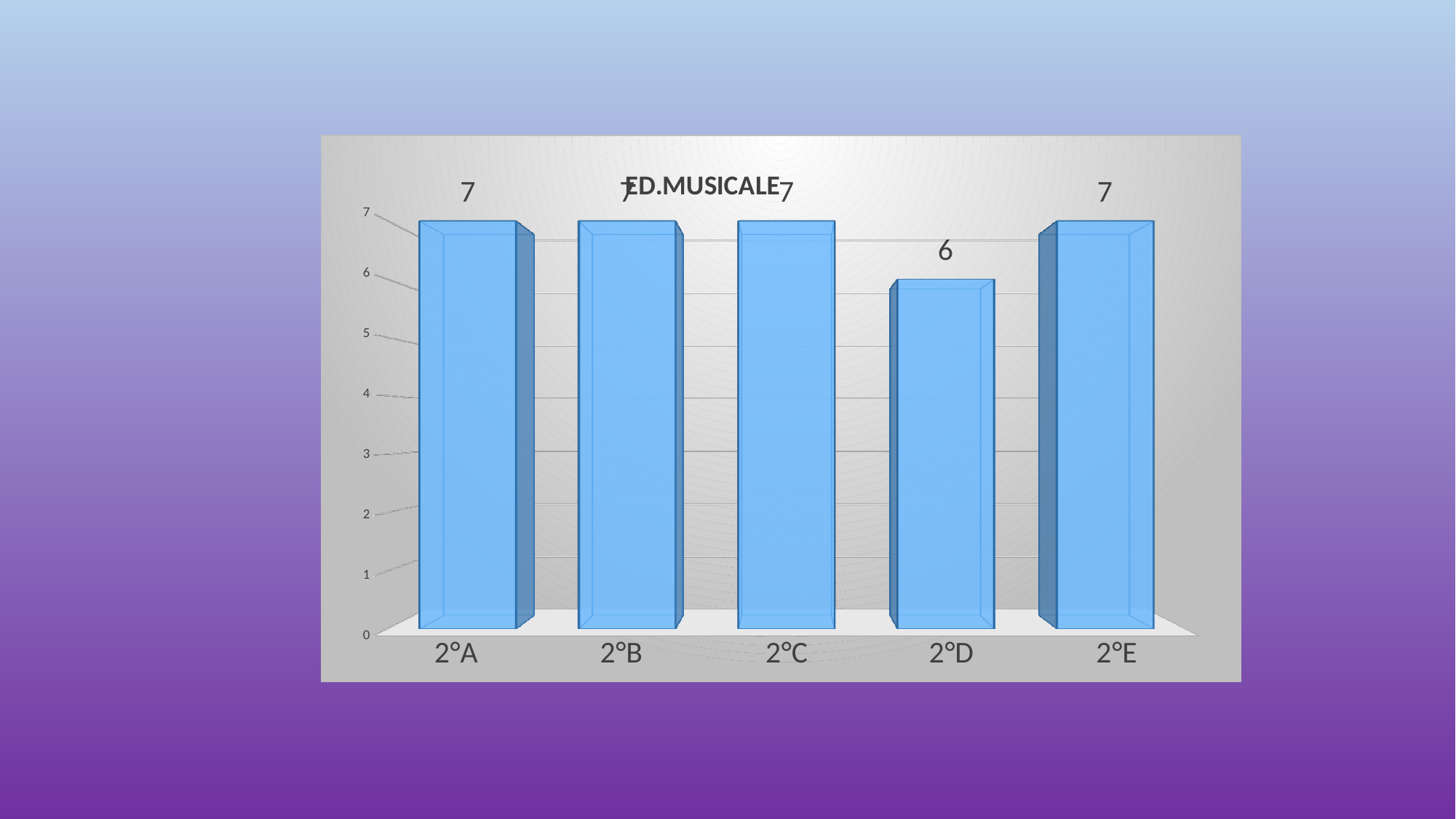
What is the value for 2°D? 6 What is the value for 2°A? 7 Which is larger, the value for 2°D or the value for 2°E? 2°E What colour are the bars in the chart? blue What is the difference between the values for 2°A and 2°D? 1 Is the value for 2°D greater or less than 5? greater What is the value for 2°C? 7 What is the value for 2°E? 7 How many categories are shown on the x axis? 5 What kind of chart is shown on the slide? bar chart Which category has the lowest value? 2°D What is the title of the chart? ED.MUSICALE